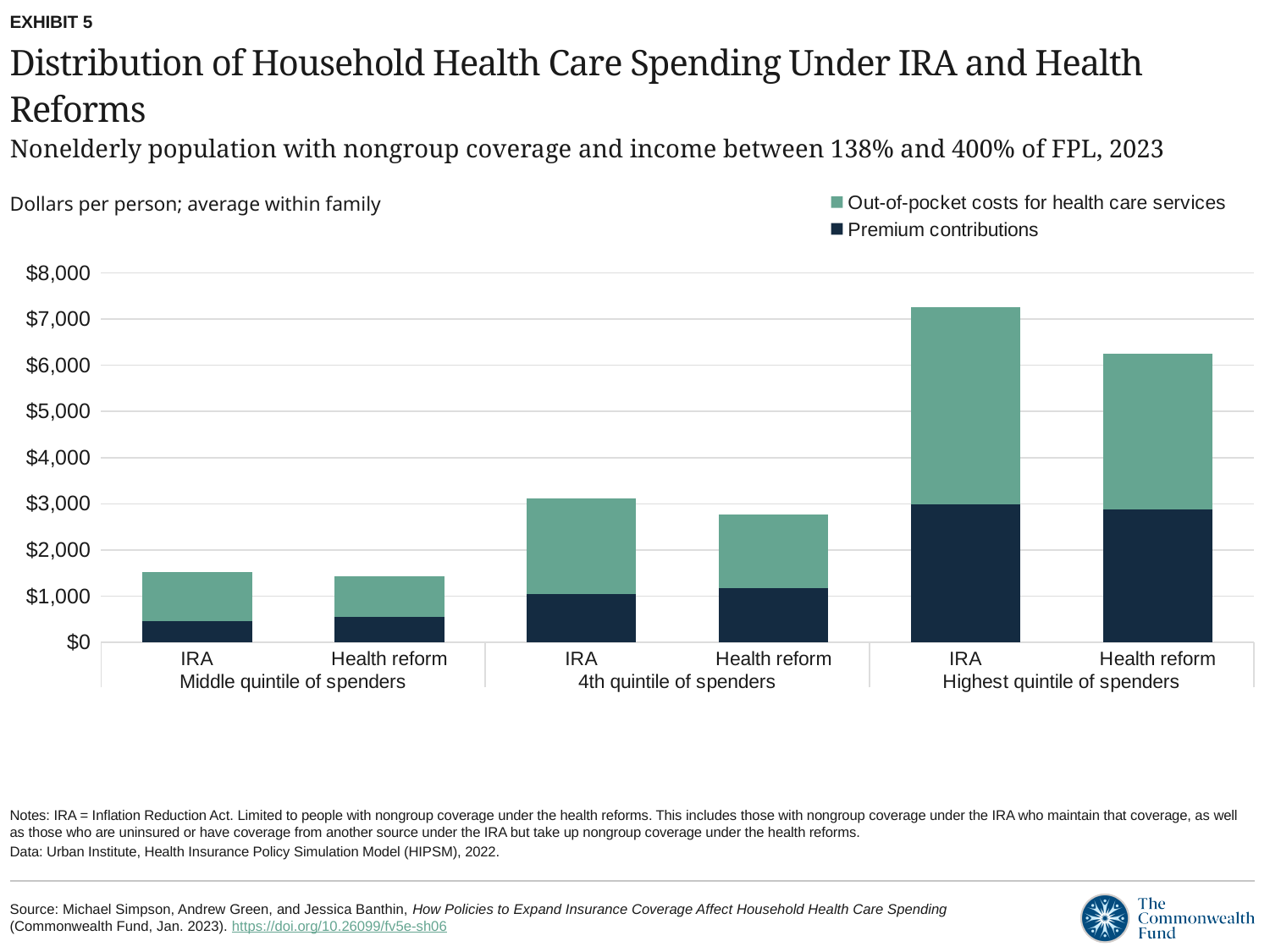
Which series is shown in dark navy in the legend? Premium contributions In the 4th quintile of spenders, which has higher total spending: IRA or Health reform? IRA Are premium contributions for IRA in the Middle quintile of spenders greater or less than $1,000? less Are premium contributions for IRA in the Highest quintile of spenders greater or less than $2,000? greater How many series does the legend list? 2 Is the total spending for Health reform in the 4th quintile of spenders greater or less than $3,000? less What kind of chart is shown on the slide? Stacked bar chart Which bar has the highest total household health care spending? IRA, Highest quintile of spenders How many bars are plotted in the chart? 6